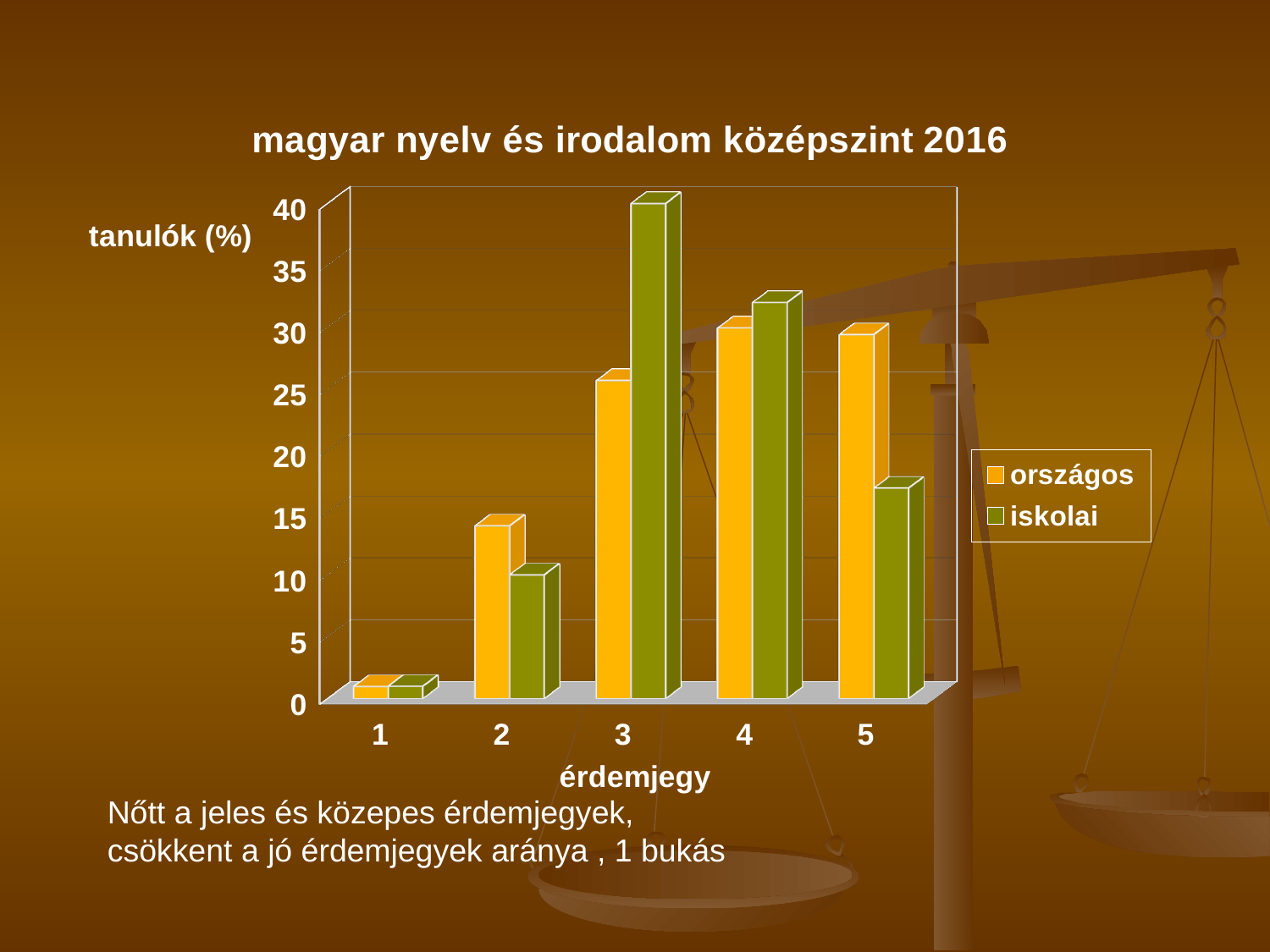
How many series does the legend list? 2 How many érdemjegy categories are shown on the x axis? 5 Is the iskolai value for érdemjegy 3 greater or less than 35? greater What is the title of the chart? magyar nyelv és irodalom középszint 2016 For which érdemjegy is the iskolai value highest? 3 Is the iskolai value for érdemjegy 5 greater or less than 20? less What kind of chart is shown on the slide? bar chart Is the országos value for érdemjegy 2 greater or less than 15? less For érdemjegy 3, which series has the larger value, országos or iskolai? iskolai What label is shown on the y axis of the chart? tanulók (%) For which érdemjegy is the iskolai value lowest? 1 For érdemjegy 5, which series has the larger value, országos or iskolai? országos